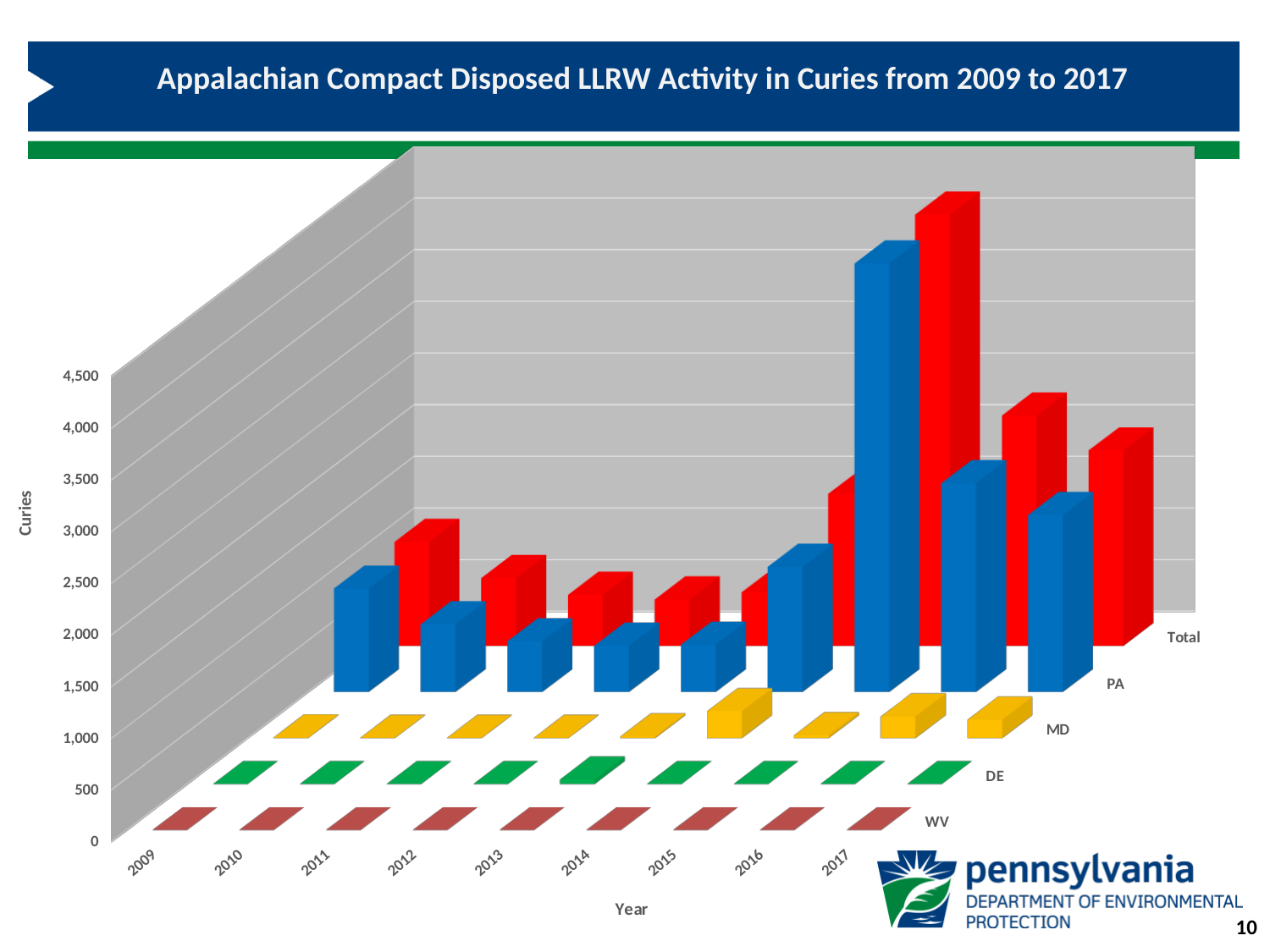
Does the PA series rise or fall from 2013 to 2015? rise How many years are shown along the x axis of the chart? 9 Which series is plotted in red? Total What is the title of the chart? Appalachian Compact Disposed LLRW Activity in Curies from 2009 to 2017 Which is larger, the PA value for 2015 or the PA value for 2009? 2015 Which is larger, the MD value for 2014 or the MD value for 2013? 2014 Is the PA value for 2015 greater or less than 2,000? greater What kind of chart is shown on the slide? Bar chart Which is larger, the Total value for 2015 or the Total value for 2016? 2015 How many series does the chart show? 5 In which year is the Total series highest? 2015 In which year is the PA series highest? 2015